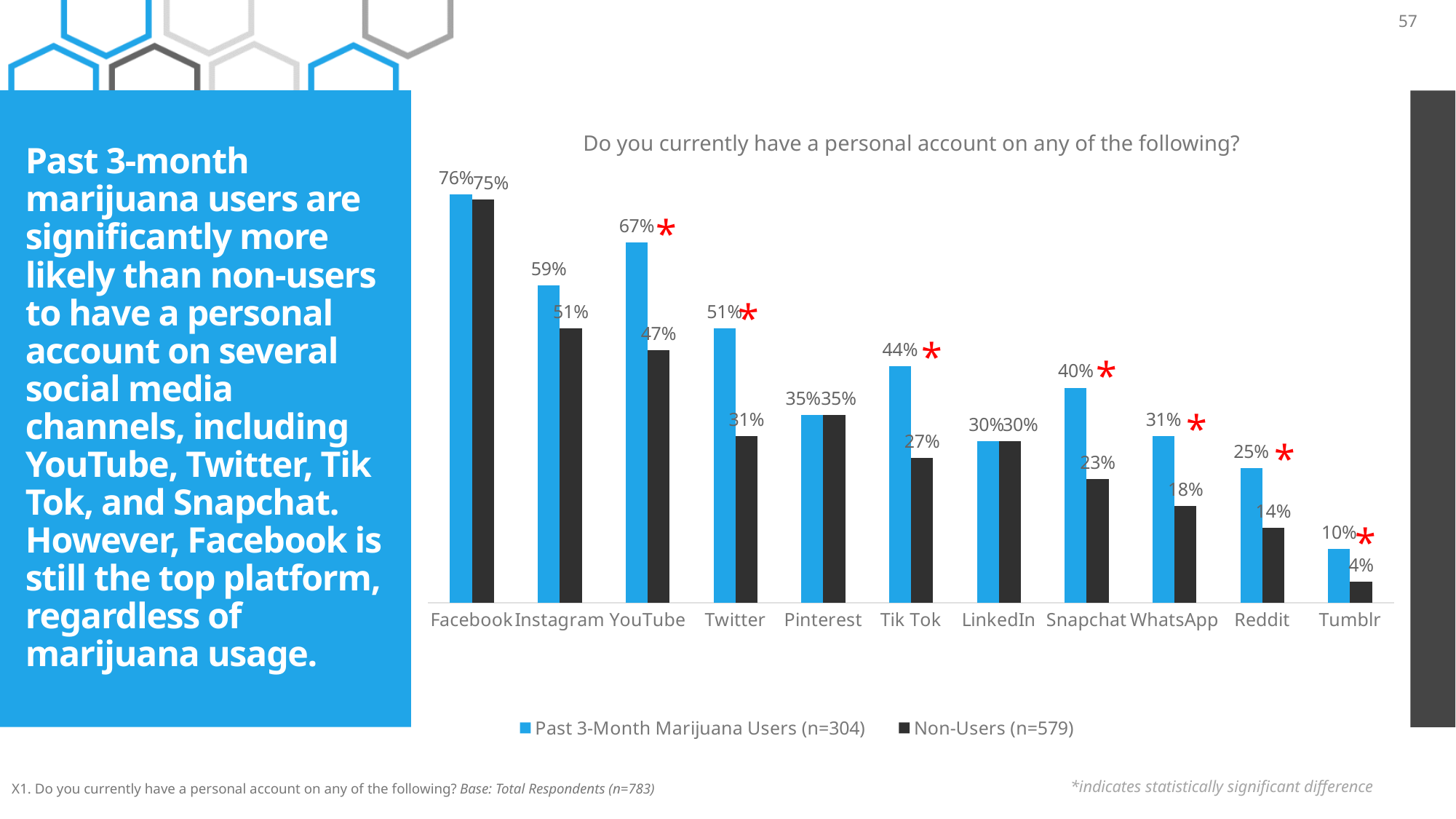
Which platform has the lowest value for Non-Users? Tumblr Which is larger for Tik Tok: the value for Past 3-Month Marijuana Users or for Non-Users? Past 3-Month Marijuana Users How many series does the legend list? 2 What percentage of Past 3-Month Marijuana Users have a personal account on YouTube? 67% What kind of chart is shown on the slide? Bar chart What is the value for Non-Users on Tumblr? 4% What percentage of Non-Users have a personal account on Twitter? 31% What is the difference between Past 3-Month Marijuana Users and Non-Users for Snapchat? 17% What is the title of the chart? Do you currently have a personal account on any of the following? How many social media platforms are shown on the x axis? 11 Which platform has the highest value for Past 3-Month Marijuana Users? Facebook What is the difference between Past 3-Month Marijuana Users and Non-Users for YouTube? 20%